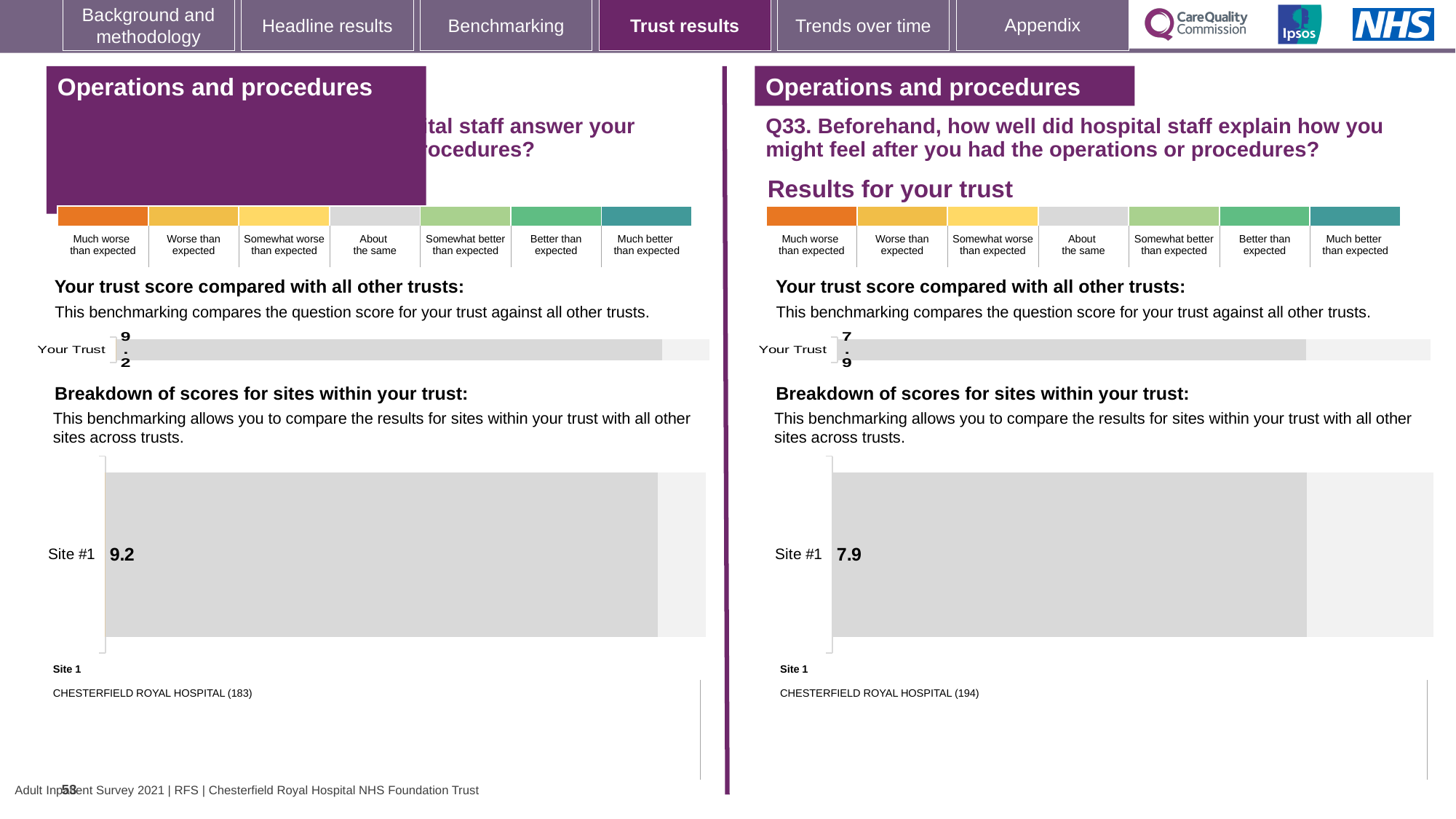
On the right half of the slide (Q33), is the Your Trust score greater or less than the Site #1 score, or are they equal? Equal On the right half of the slide (Q33), what is the score shown for Your Trust in the 'Your trust score compared with all other trusts' chart? 7.9 On the left half of the slide, what score is shown for Site #1 in the 'Breakdown of scores for sites within your trust' chart? 9.2 What type of chart is used to show the Site #1 score on the left half of the slide? Bar chart On the left half of the slide, what is the score shown for Your Trust in the 'Your trust score compared with all other trusts' chart? 9.2 On the right half of the slide (Q33), which site name is listed under Site 1 below the breakdown chart? CHESTERFIELD ROYAL HOSPITAL (194) On the left half of the slide, which site name is listed under Site 1 below the breakdown chart? CHESTERFIELD ROYAL HOSPITAL (183) On the right half of the slide (Q33), what score is shown for Site #1 in the 'Breakdown of scores for sites within your trust' chart? 7.9 Which is larger: the Site #1 score on the left half of the slide or the Site #1 score on the right half (Q33)? Left half (9.2) How many sites are shown in the 'Breakdown of scores for sites within your trust' chart on the right half of the slide (Q33)? 1 What is the difference between the Your Trust score on the left half of the slide and the Your Trust score on the right half (Q33)? 1.3